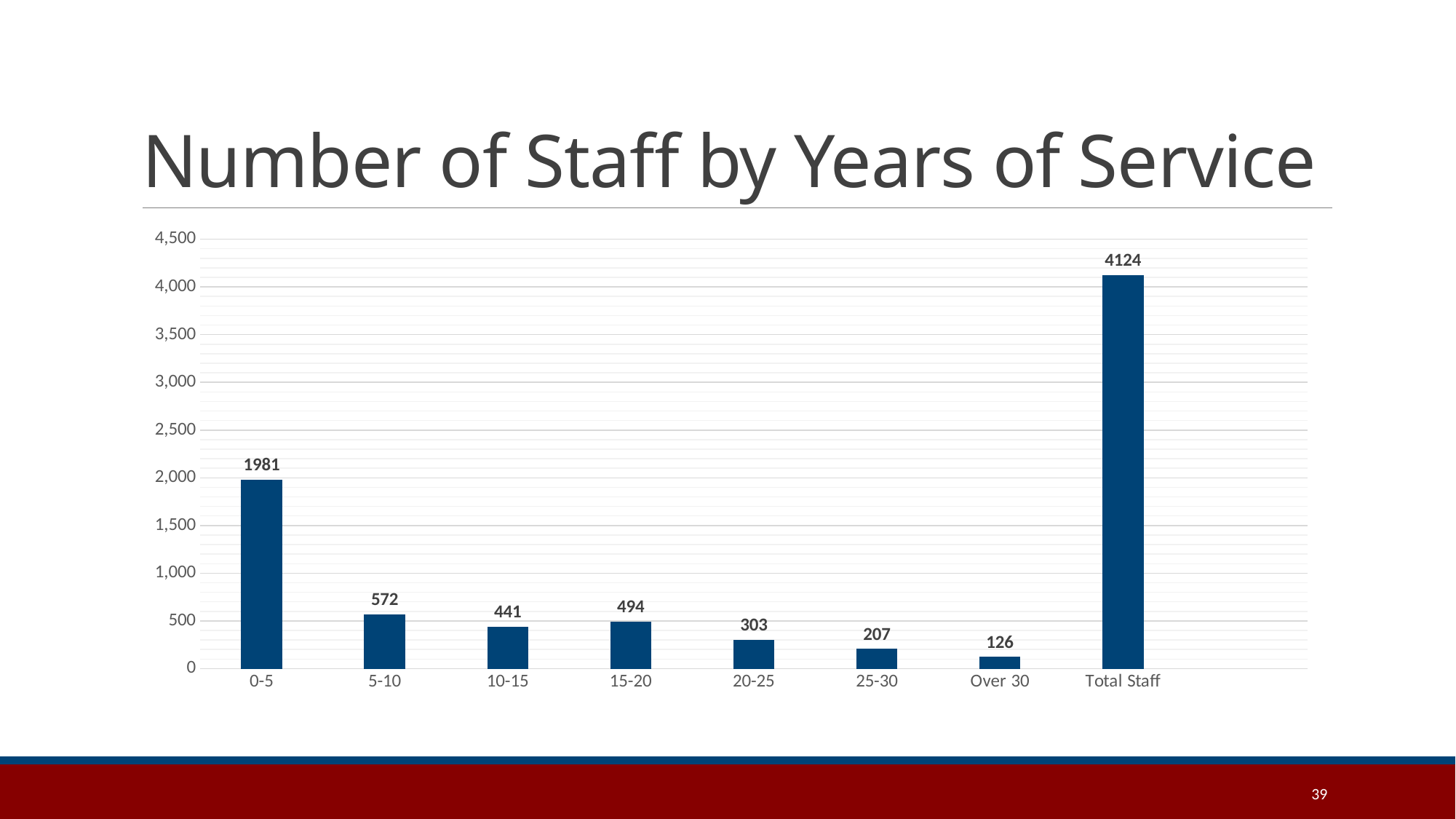
What is the number of staff with 15-20 years of service? 494 What is the value shown for Over 30 years of service? 126 Which category has the lowest number of staff? Over 30 What is the title of the chart? Number of Staff by Years of Service What is the difference between the number of staff with 5-10 years of service and those with 10-15 years of service? 131 How many bars are shown in the chart? 8 Is the value for 25-30 years of service greater or less than 500? less What is the number of staff with 0-5 years of service? 1981 Which has more staff: 15-20 years of service or 20-25 years of service? 15-20 What type of chart is shown on the slide? bar chart What is the value shown for Total Staff? 4124 Excluding the Total Staff bar, which years-of-service category has the highest number of staff? 0-5